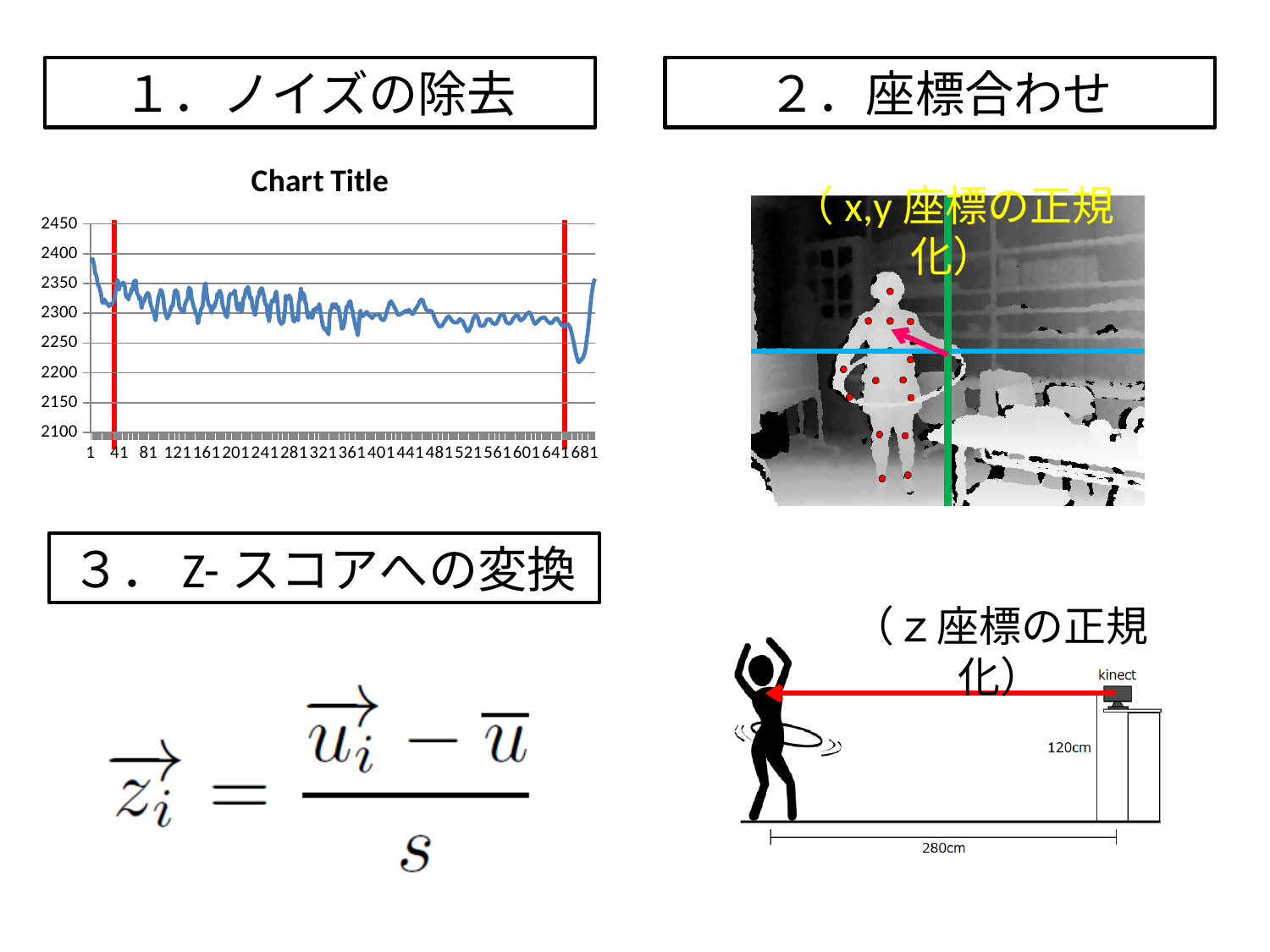
Is the value of the line at x = 1 greater or less than 2350? greater What is the lowest value labelled on the chart's vertical axis? 2100 Is the value of the line at x = 321 greater or less than 2200? greater What is the highest value labelled on the chart's vertical axis? 2450 What is the title of the chart on the slide? Chart Title What is the last tick label on the chart's horizontal axis? 681 Do the values of the line generally rise or fall from x = 1 to x = 641? fall Is the lowest point of the line, in the dip near x = 661, greater or less than 2250? less What kind of chart is shown under "1. ノイズの除去"? line chart How many tick labels are shown on the chart's horizontal axis? 18